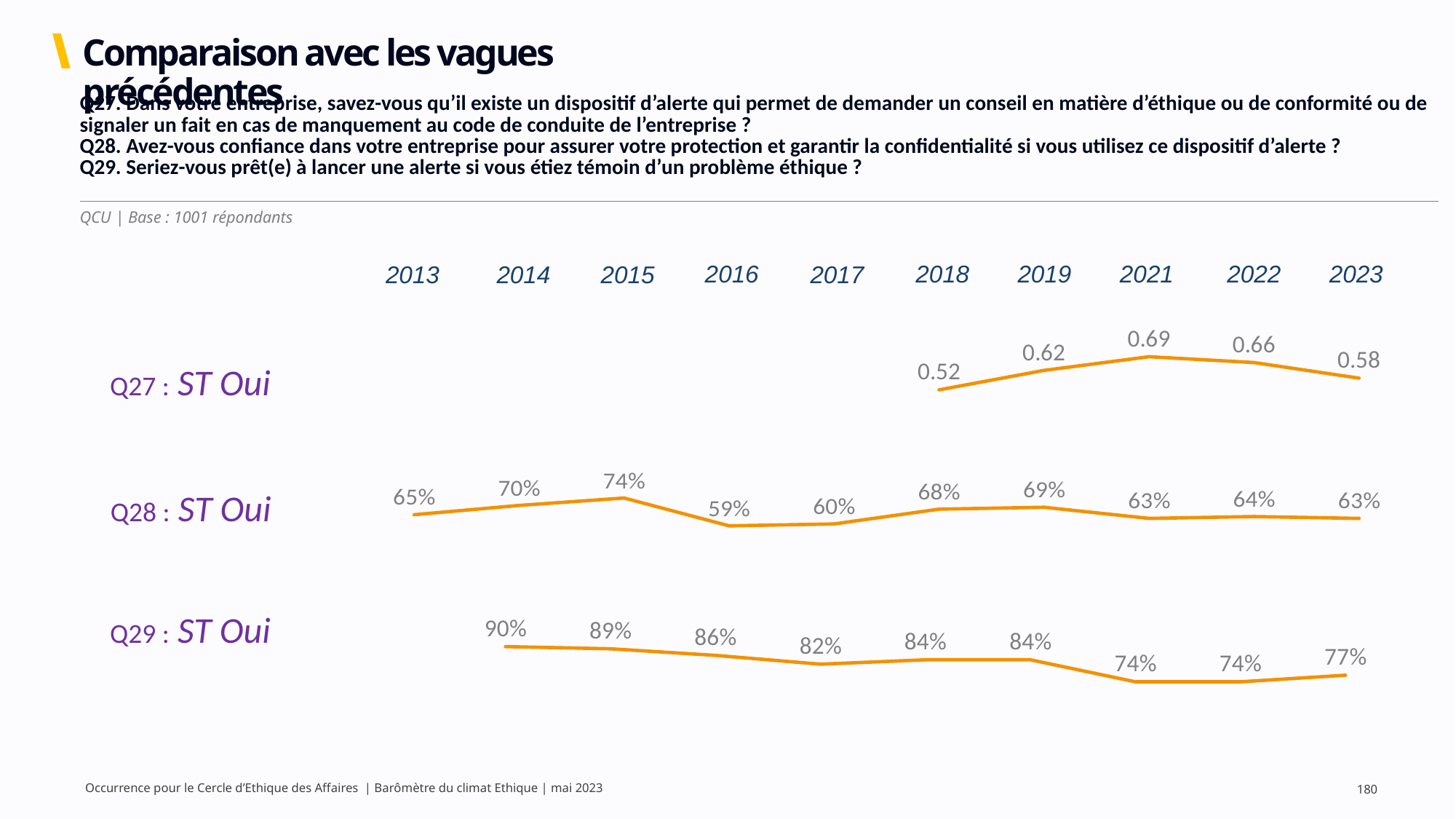
In the Q29 : ST Oui chart, do the values generally rise or fall from 2014 to 2022? fall In the Q27 : ST Oui chart, which year has the lowest value? 2018 In the Q27 : ST Oui chart, how many data points are plotted? 5 In the Q28 : ST Oui chart, what is the difference between the 2015 value and the 2016 value? 15 percentage points In the Q29 : ST Oui chart, what is the value for 2023? 77% In the Q29 : ST Oui chart, which year has the highest value? 2014 In the Q28 : ST Oui chart, how many years are plotted? 10 What type of chart is used for the Q28 : ST Oui series? line chart In the Q28 : ST Oui chart, which year has the highest value? 2015 In the Q27 : ST Oui chart, what is the value for 2021? 0.69 In the Q29 : ST Oui chart, is the value for 2017 larger or smaller than the value for 2018? smaller In the Q28 : ST Oui chart, what is the value for 2016? 59%